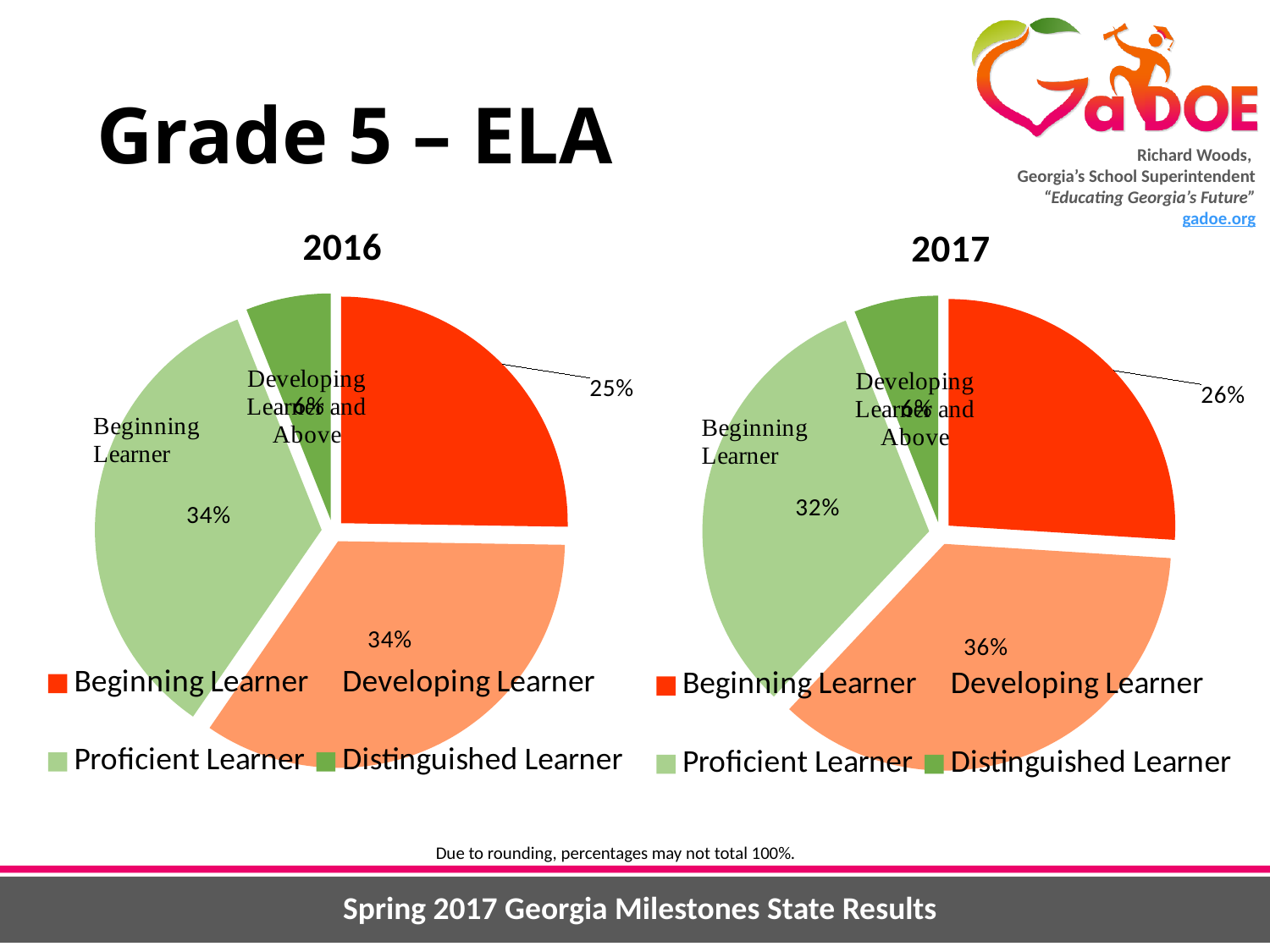
In the 2016 pie chart, which category has the smallest share? Distinguished Learner Is the Proficient Learner share larger in the 2016 chart or the 2017 chart? 2016 In the 2016 pie chart, what percentage is shown for Distinguished Learner? 6% In the 2017 pie chart, what percentage is shown for Developing Learner? 36% What type of chart is used to show the 2016 results? Pie chart What is the difference between the Developing Learner percentage in 2017 and in 2016? 2% In the 2017 pie chart, what percentage is shown for Proficient Learner? 32% In the 2017 pie chart, which category has the largest share? Developing Learner How many categories does the 2017 pie chart show? 4 How many entries does the legend of the 2016 chart list? 4 In the 2016 chart, what colour represents Beginning Learner in the legend? Red In the 2016 pie chart, what percentage is shown for Beginning Learner? 25%